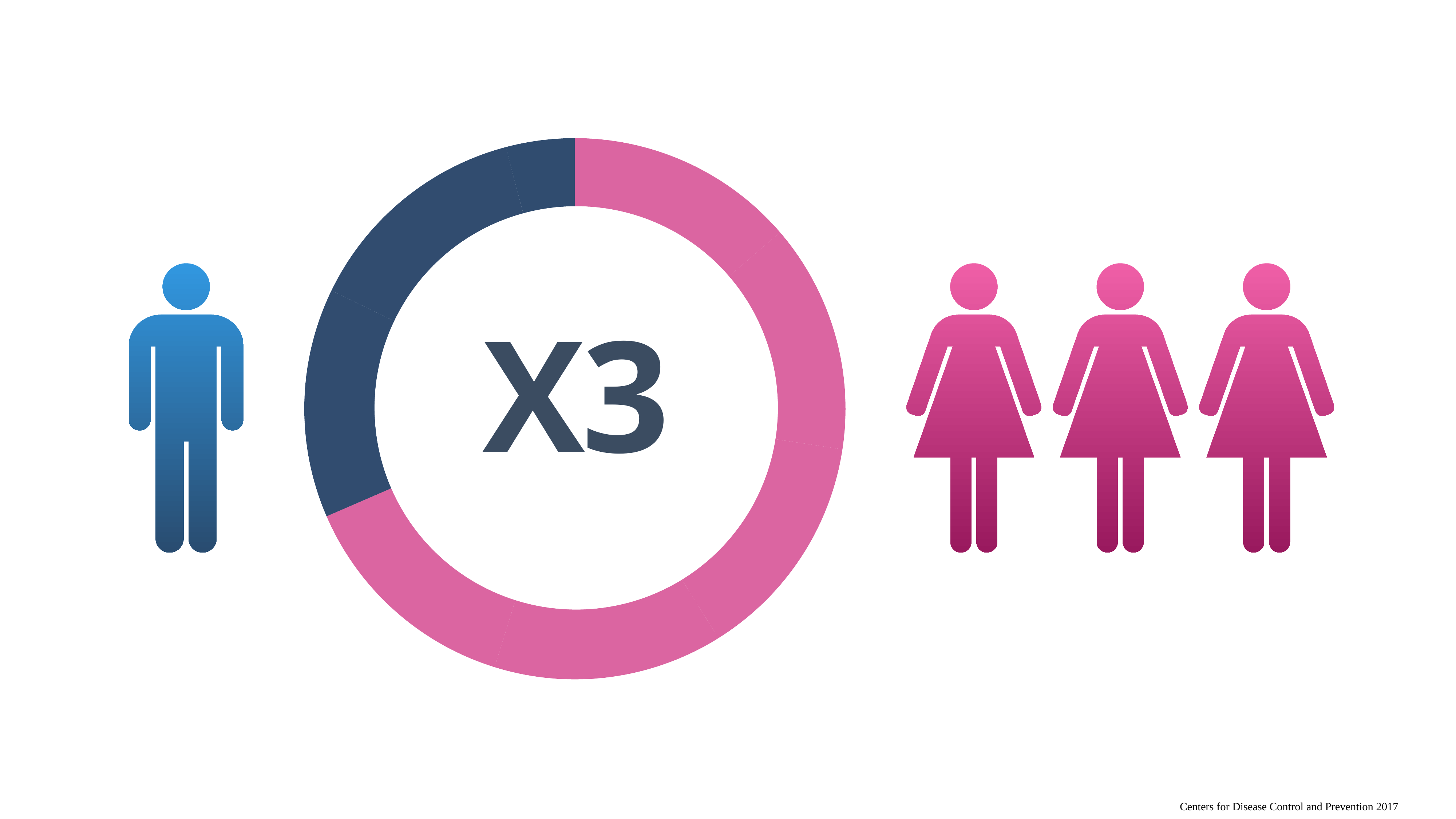
What kind of chart is shown on the slide? Donut chart How many segments does the donut chart have? 2 Which colour segment of the donut chart is the smallest? Dark blue Does the pink segment of the donut chart cover more or less than half of the ring? More Which segment of the donut chart is larger, the pink one or the dark blue one? The pink one What text is displayed in the centre of the donut chart? X3 What source is cited at the bottom right of the slide? Centers for Disease Control and Prevention 2017